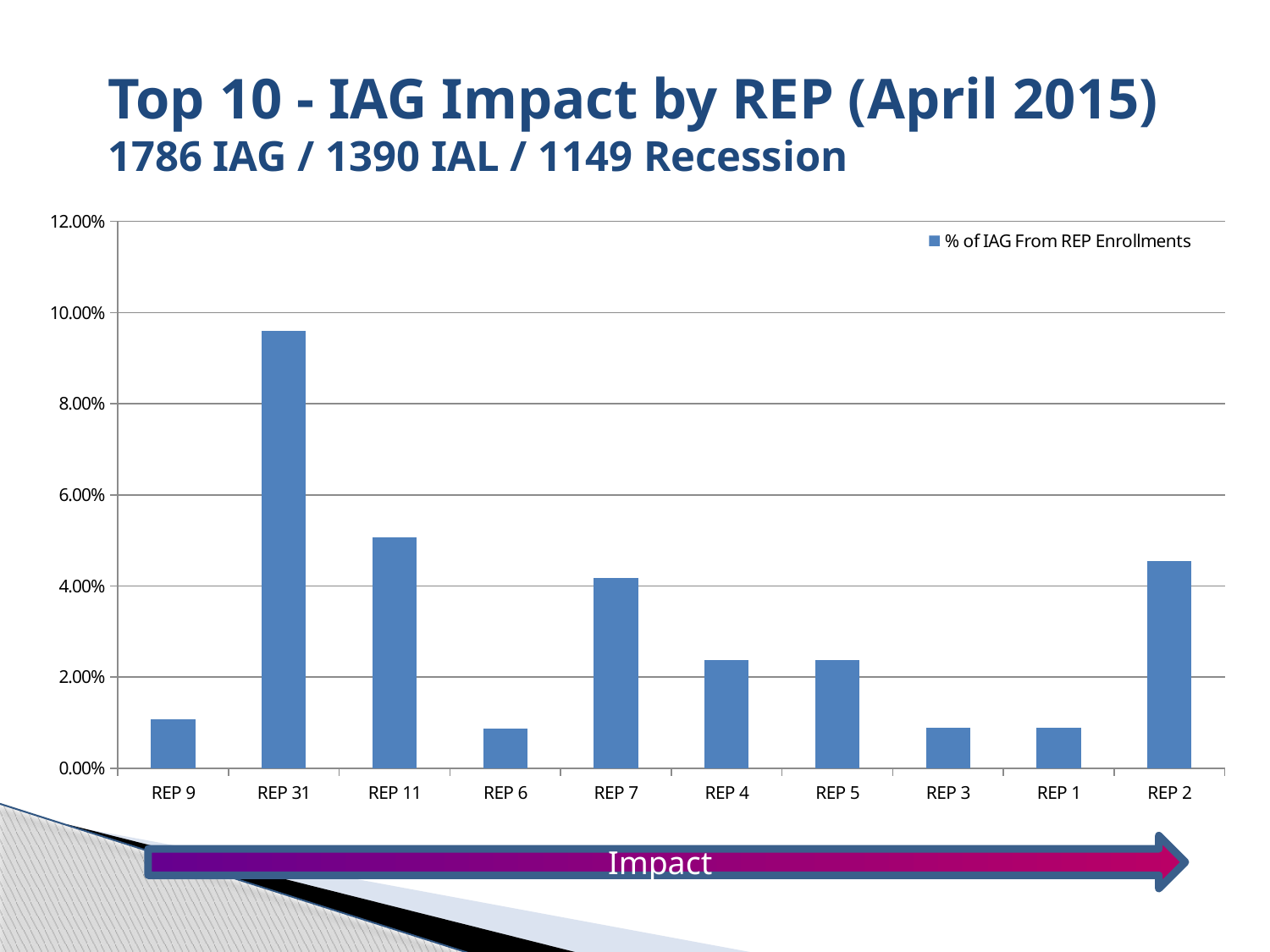
Is the value for REP 6 greater or less than 2.00%? less Which is larger, the value for REP 7 or the value for REP 4? REP 7 Which REP has the highest % of IAG From REP Enrollments? REP 31 What kind of chart is shown on the slide? bar chart Is the value for REP 31 greater or less than 8.00%? greater What series name is shown in the chart legend? % of IAG From REP Enrollments Is the value for REP 2 greater or less than 6.00%? less How many REP categories are plotted on the x axis? 10 How many series does the legend list? 1 Which is larger, the value for REP 31 or the value for REP 11? REP 31